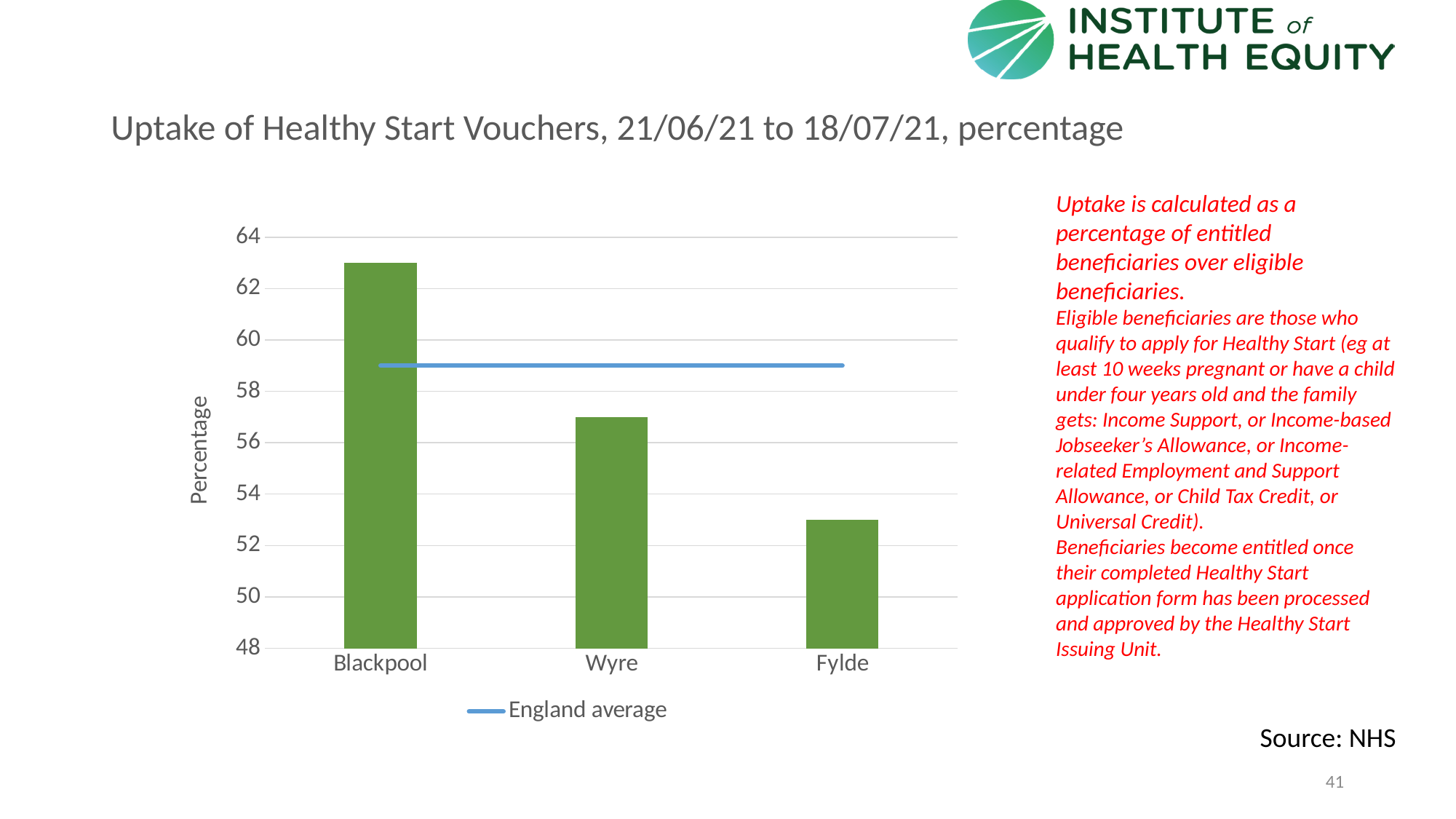
Which has the higher uptake, Wyre or Fylde? Wyre Do the bar values rise or fall moving from Blackpool to Fylde along the x axis? fall What is the label on the vertical axis of the chart? Percentage How many local areas are shown as bars on the chart? 3 Is the value for Blackpool greater or less than 62? greater Is the value for Wyre greater or less than 58? less Is the England average line greater or less than 60? less Which area has the highest uptake of Healthy Start vouchers? Blackpool How many entries does the chart legend list? 1 What kind of chart is shown on the slide? bar chart Which area has the lowest uptake of Healthy Start vouchers? Fylde